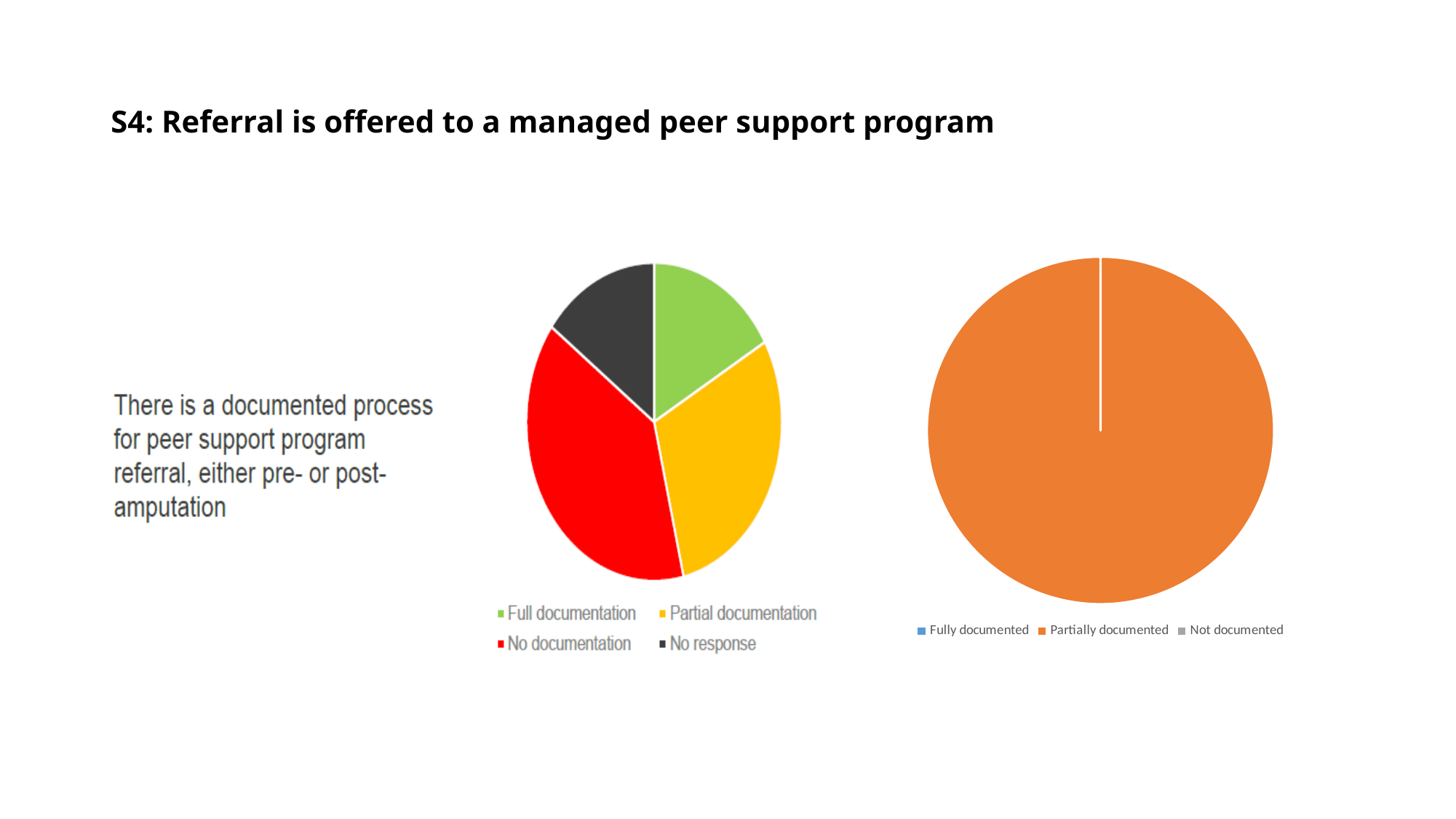
What kind of chart is the left chart on the slide? Pie chart What kind of chart is the right chart on the slide? Pie chart In the left pie chart, which category has the largest slice? No documentation In the left pie chart, which slice is larger: Partial documentation or Full documentation? Partial documentation In the left pie chart, what colour is the No response slice? Black In the right pie chart, what share of the pie does Partially documented take up? 100% In the right pie chart, which category accounts for the entire pie? Partially documented In the right pie chart, how many categories does the legend list? 3 In the left pie chart, what colour is the No documentation slice? Red In the left pie chart, how many categories does the legend list? 4 In the left pie chart, which slice is larger: No documentation or Partial documentation? No documentation